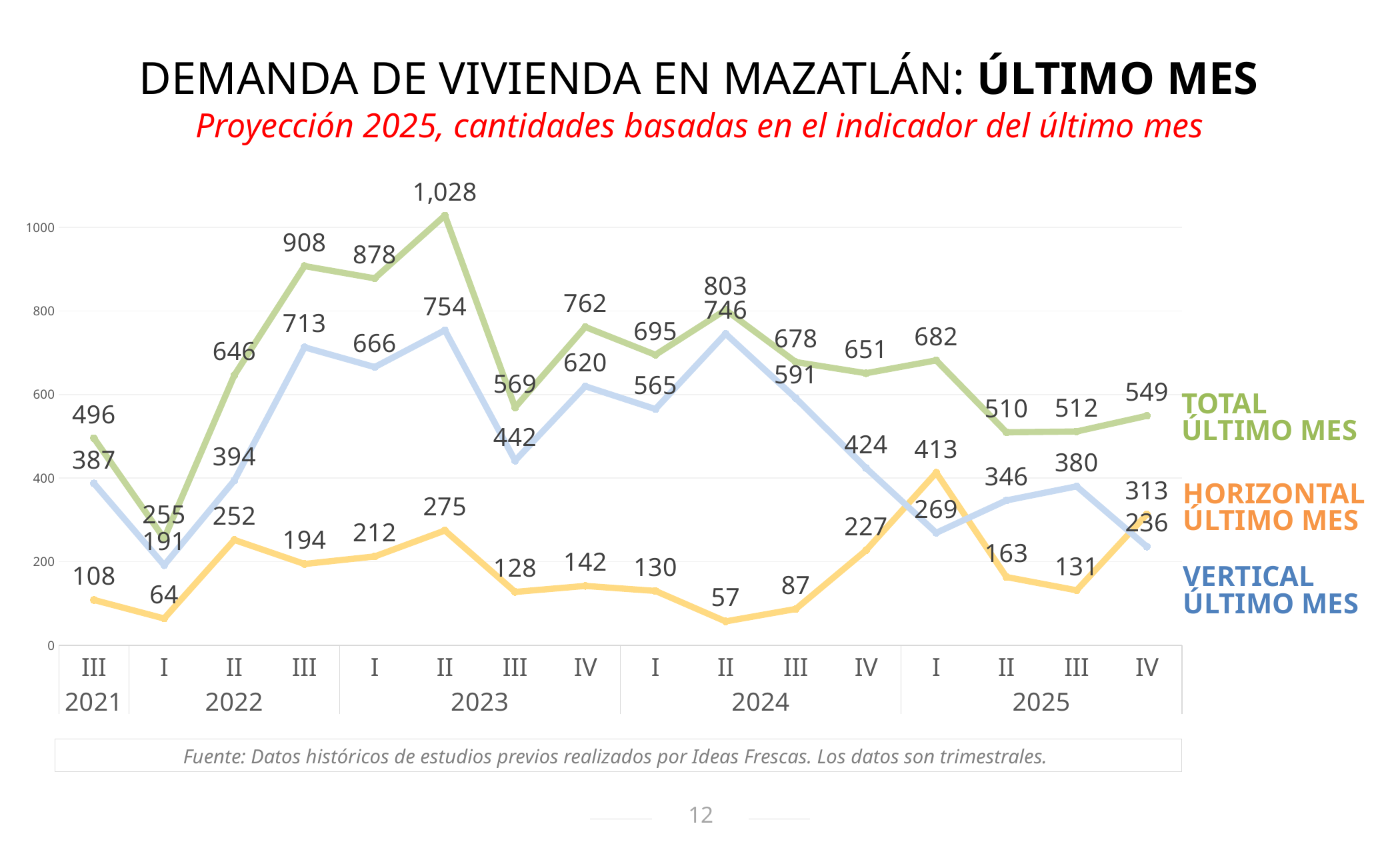
How many quarters are plotted on the x axis? 16 What is the difference between TOTAL ÚLTIMO MES in quarter III of 2022 and quarter I of 2022? 653 What is the value of TOTAL ÚLTIMO MES in quarter II of 2023? 1,028 What is the value of VERTICAL ÚLTIMO MES in quarter III of 2022? 713 Is the value of VERTICAL ÚLTIMO MES in quarter II of 2024 greater or less than 600? greater Which is larger in quarter I of 2025: HORIZONTAL ÚLTIMO MES or VERTICAL ÚLTIMO MES? HORIZONTAL ÚLTIMO MES In which quarter is HORIZONTAL ÚLTIMO MES at its lowest? II 2024 Does TOTAL ÚLTIMO MES rise or fall from quarter II of 2024 to quarter II of 2025? Fall What is the value of HORIZONTAL ÚLTIMO MES in quarter I of 2025? 413 What kind of chart is shown on the slide? Line chart In which quarter does TOTAL ÚLTIMO MES reach its highest value? II 2023 How many series does the chart show? 3